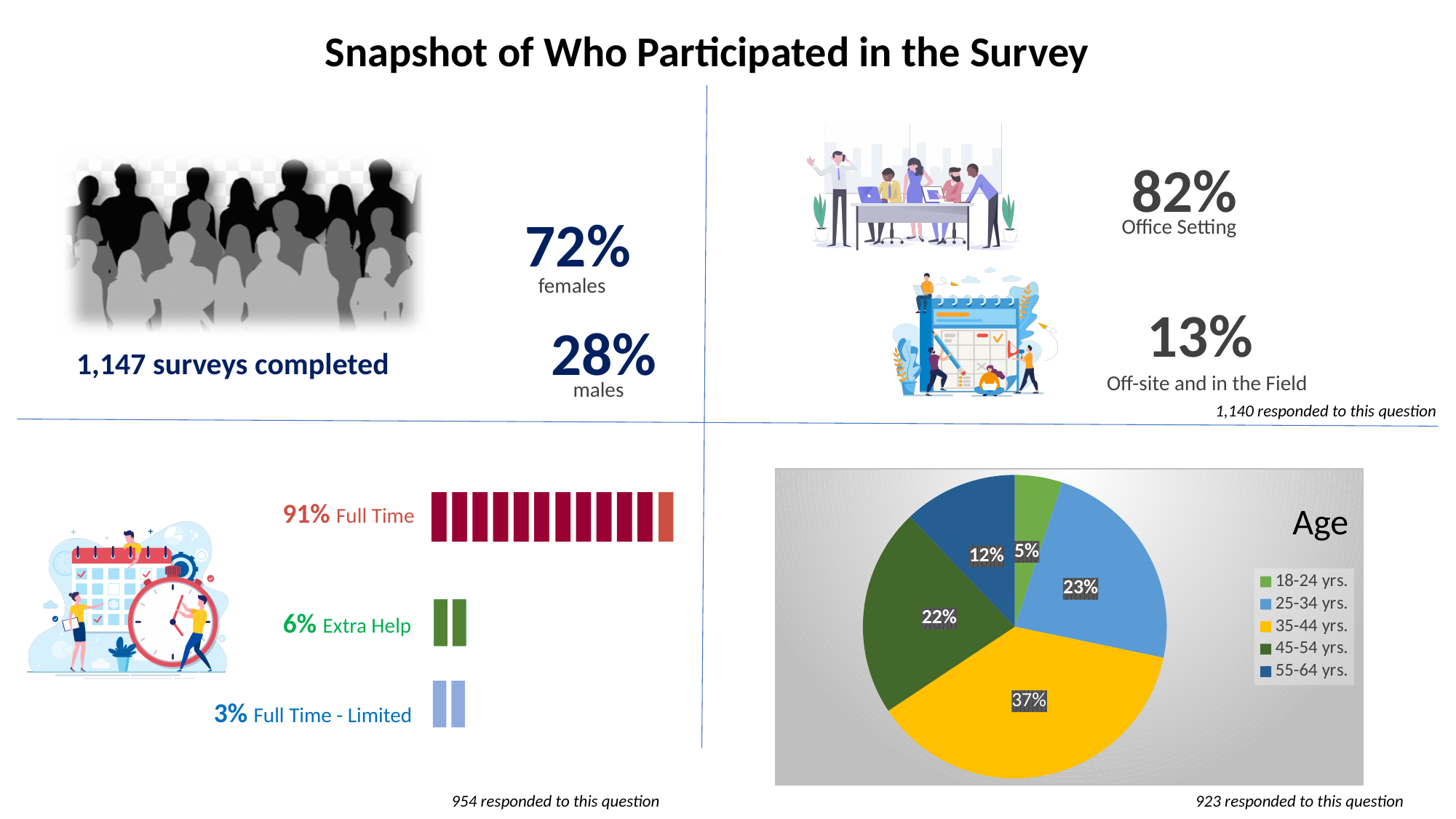
On the Age pie chart, what colour is the 35-44 yrs. slice? Yellow On the Age pie chart, what share of respondents are 25-34 yrs.? 23% On the Age pie chart, which age group has the largest share? 35-44 yrs. On the Age pie chart, what is the combined share of the 45-54 yrs. and 55-64 yrs. slices? 34% On the Age pie chart, which age group has the smallest share? 18-24 yrs. On the Age pie chart, what share of respondents are 18-24 yrs.? 5% On the Age pie chart, which slice is larger: 25-34 yrs. or 55-64 yrs.? 25-34 yrs. What kind of chart is used to show the age breakdown on the slide? Pie chart On the Age pie chart, what share of respondents are 55-64 yrs.? 12% How many age groups does the Age pie chart show? 5 On the Age pie chart, what is the difference in percentage points between the 35-44 yrs. slice and the 45-54 yrs. slice? 15 On the Age pie chart, what share of respondents are 35-44 yrs.? 37%